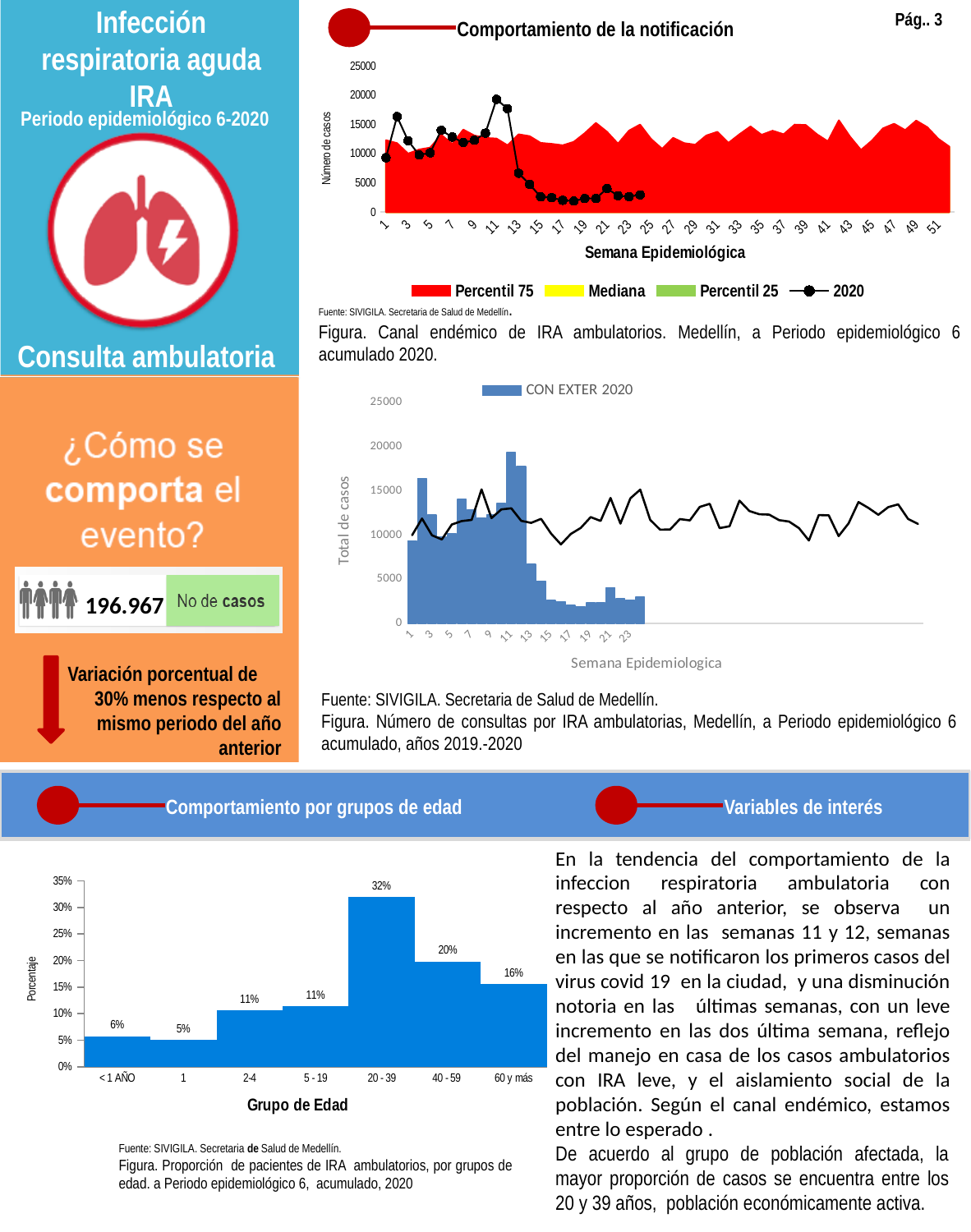
In the bottom-left chart of IRA patients by age group, which age group has the lowest percentage? 1 How many age groups are shown on the x axis of the bottom-left chart of IRA patients by age group? 7 In the bottom-left chart of IRA patients by age group, which age group has the highest percentage? 20 - 39 In the bottom-left chart of IRA patients by age group, what percentage is shown for the 20 - 39 group? 32% How many series does the legend list in the top-right chart 'Comportamiento de la notificación'? 4 In the bottom-left chart of IRA patients by age group, which is larger: the percentage for < 1 AÑO or for 40 - 59? 40 - 59 In the bottom-left chart of IRA patients by age group, what is the difference between the percentages for 20 - 39 and 40 - 59? 12% What is the y-axis title of the middle chart 'CON EXTER 2020'? Total de casos In the top-right chart 'Comportamiento de la notificación', is the 2020 value at week 11 greater or less than 15000? greater In the bottom-left chart of IRA patients by age group, what percentage is shown for the 60 y más group? 16% In the middle chart 'CON EXTER 2020', is the bar for week 17 greater or less than 5000? less What kind of chart is the bottom-left chart of IRA patients by age group? Bar chart